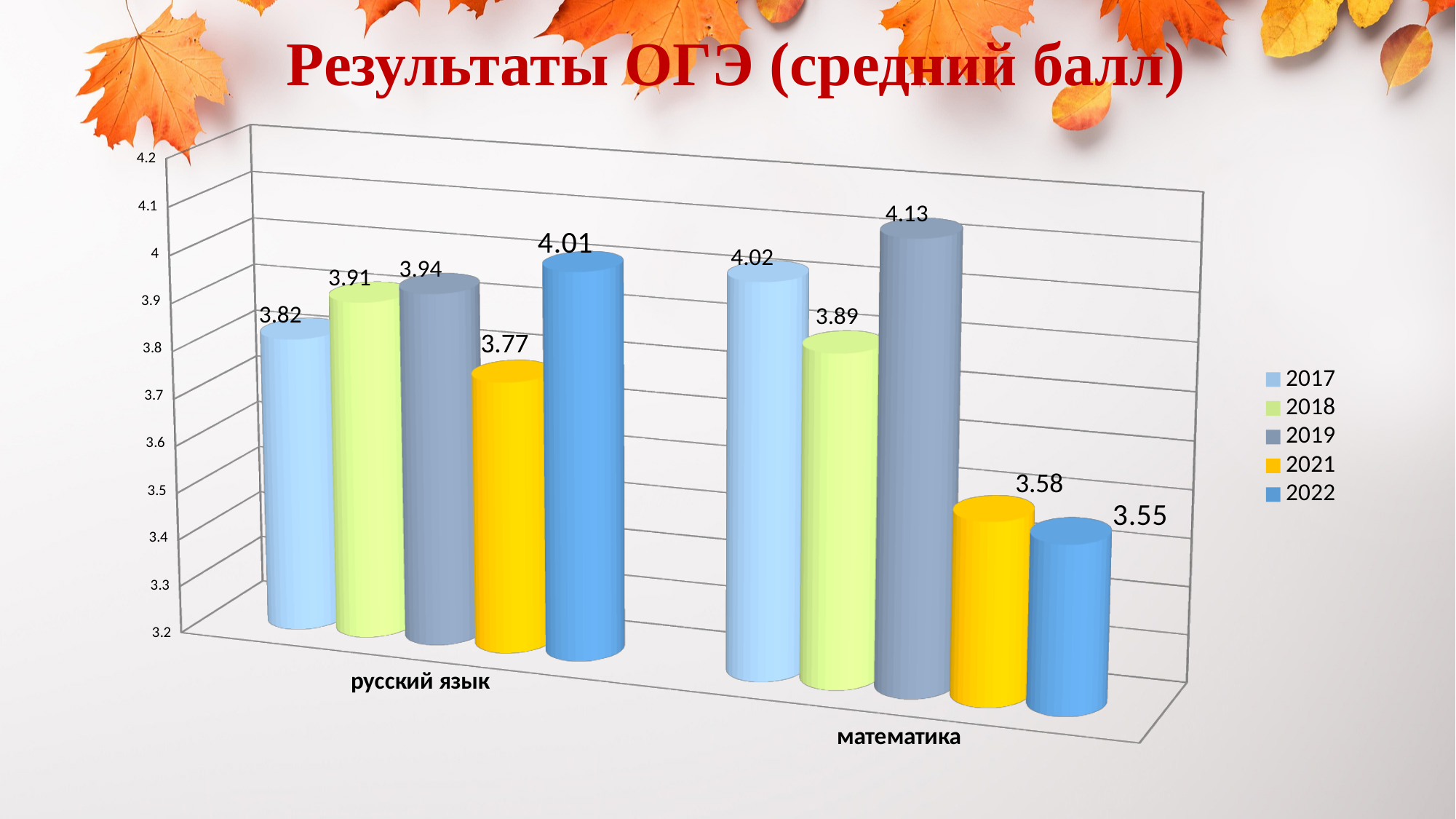
Which year has the highest value in the математика category? 2019 Which is larger: the 2018 value for русский язык or the 2018 value for математика? русский язык What is the value for 2017 in the математика category? 4.02 Which year has the lowest value in the русский язык category? 2021 How many categories are shown on the x axis? 2 What is the value for 2021 in the русский язык category? 3.77 What is the difference between the 2019 and 2022 values in the математика category? 0.58 What is the value for 2019 in the математика category? 4.13 What kind of chart is shown on the slide? bar chart How many series does the legend list? 5 What is the value for 2022 in the русский язык category? 4.01 What is the title of the chart on the slide? Результаты ОГЭ (средний балл)